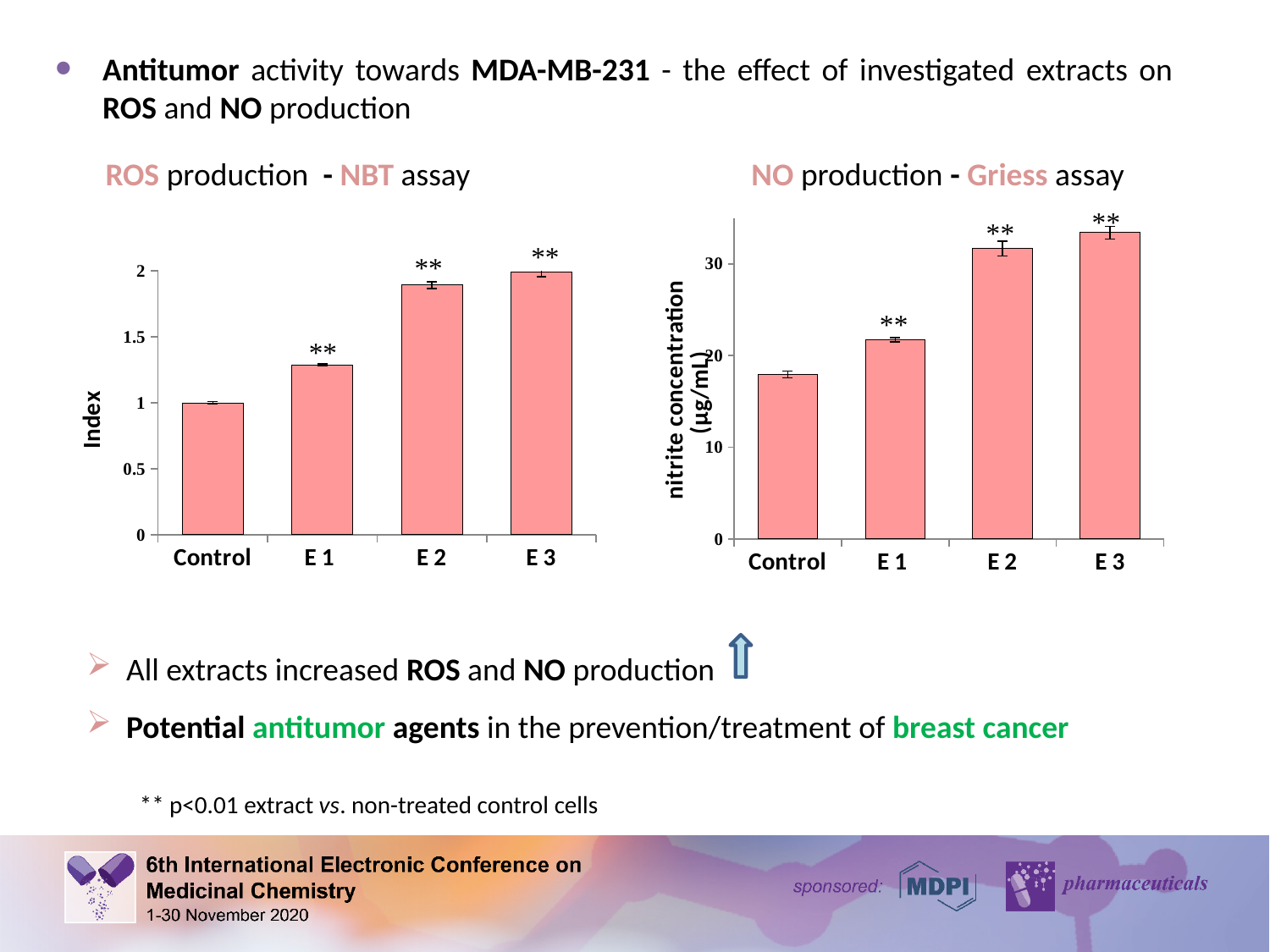
In the ROS production - NBT assay chart, is the Index for E 2 greater or less than 1.5? greater In the ROS production - NBT assay chart, do the Index values rise or fall from Control to E 3? rise In the NO production - Griess assay chart, which category has the lowest nitrite concentration? Control In the NO production - Griess assay chart, is the nitrite concentration for Control greater or less than 20? less What kind of chart is the ROS production - NBT assay chart? bar chart In the ROS production - NBT assay chart, what is the Index value for Control? 1 In the ROS production - NBT assay chart, which category has the lowest Index? Control How many categories are shown on the x axis of the NO production - Griess assay chart? 4 What is the y-axis label of the NO production - Griess assay chart? nitrite concentration (µg/mL) In the ROS production - NBT assay chart, is the Index for E 1 greater or less than 1.5? less In the NO production - Griess assay chart, which is larger, the value for E 1 or the value for Control? E 1